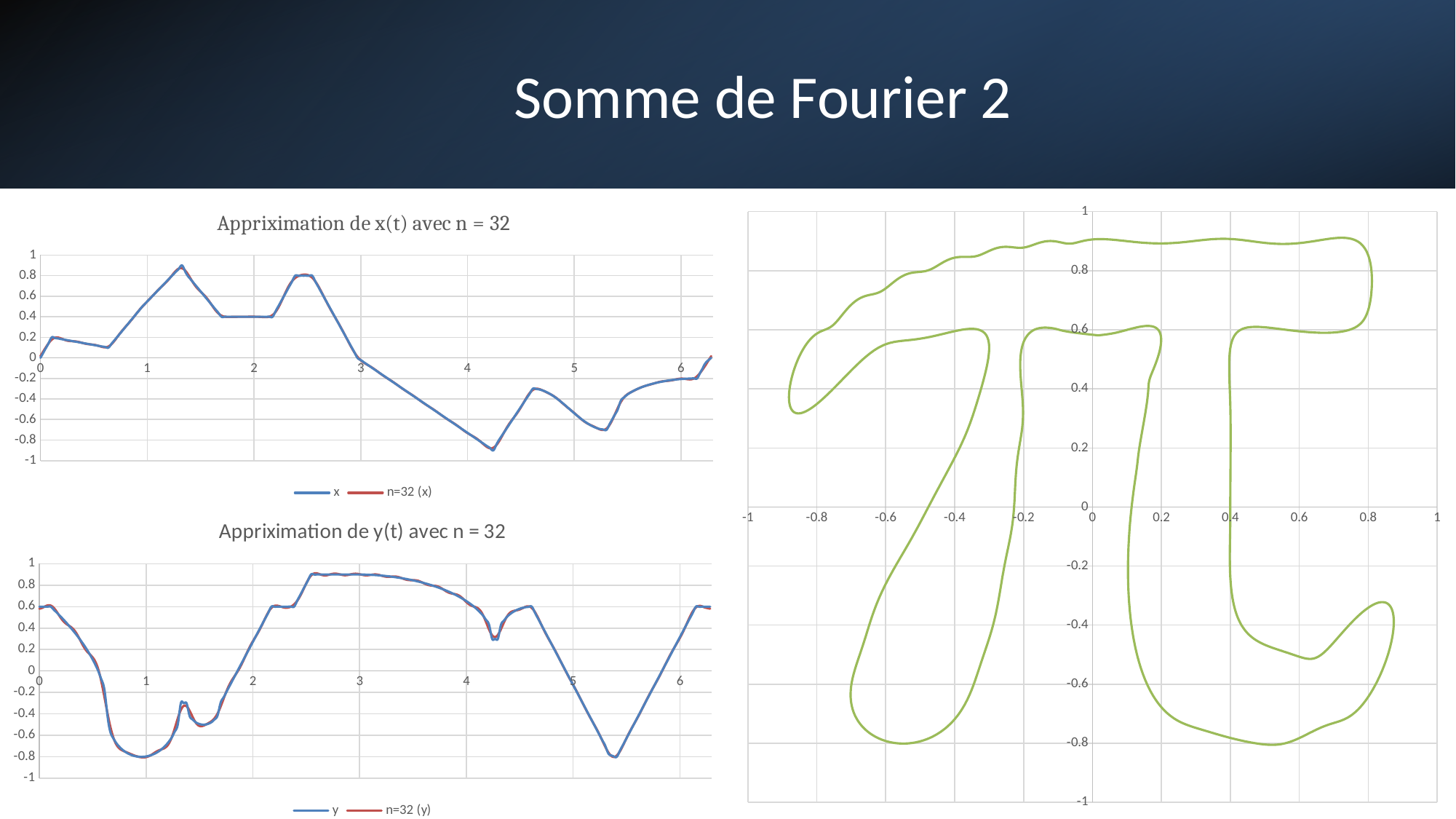
How many series does the legend of the top-left chart "Appriximation de x(t) avec n = 32" list? 2 In the top-left chart "Appriximation de x(t) avec n = 32", is the value of x at t = 1 greater or less than 0.4? greater In the top-left chart "Appriximation de x(t) avec n = 32", is the value of x at t = 4 greater or less than -0.4? less What kind of chart is the top-left chart titled "Appriximation de x(t) avec n = 32"? line chart In the bottom-left chart "Appriximation de y(t) avec n = 32", does the y series rise or fall between t = 2 and t = 2.5? rise How many series does the legend of the bottom-left chart "Appriximation de y(t) avec n = 32" list? 2 In the bottom-left chart "Appriximation de y(t) avec n = 32", is the value of y at t = 3 greater or less than 0.8? greater What are the two legend entries of the bottom-left chart "Appriximation de y(t) avec n = 32"? y and n=32 (y) What shape does the curve in the right-hand chart trace out? the Greek letter pi How many charts are shown on the slide? 3 In the top-left chart "Appriximation de x(t) avec n = 32", does the x series rise or fall between t = 3 and t = 4? fall